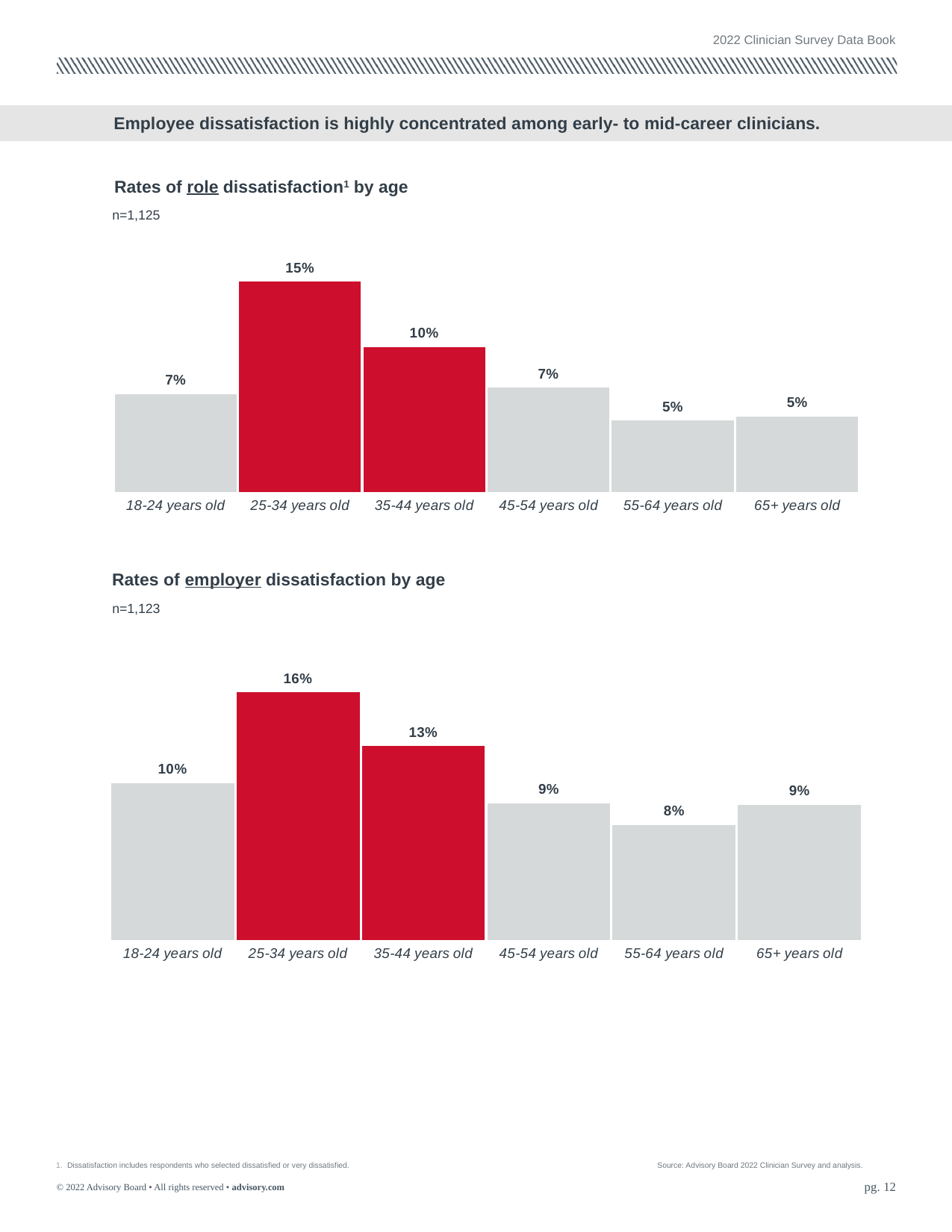
In the 'Rates of role dissatisfaction by age' chart, how many age groups are shown? 6 In the 'Rates of role dissatisfaction by age' chart, do the values rise or fall from 25-34 years old to 65+ years old? Fall In the 'Rates of employer dissatisfaction by age' chart, what is the difference between the values for 25-34 years old and 18-24 years old? 6% In the 'Rates of role dissatisfaction by age' chart, what is the value for 25-34 years old? 15% In the 'Rates of employer dissatisfaction by age' chart, which is larger: the value for 18-24 years old or the value for 45-54 years old? 18-24 years old In the 'Rates of role dissatisfaction by age' chart, what is the difference between the values for 25-34 years old and 35-44 years old? 5% In the 'Rates of employer dissatisfaction by age' chart, which age group has the lowest rate? 55-64 years old In the 'Rates of role dissatisfaction by age' chart, which age group has the highest rate? 25-34 years old What is the sample size (n) shown for the 'Rates of employer dissatisfaction by age' chart? n=1,123 In the 'Rates of role dissatisfaction by age' chart, which age groups are highlighted in red? 25-34 years old and 35-44 years old What type of chart is the 'Rates of employer dissatisfaction by age' chart? Bar chart In the 'Rates of employer dissatisfaction by age' chart, what is the value for 35-44 years old? 13%